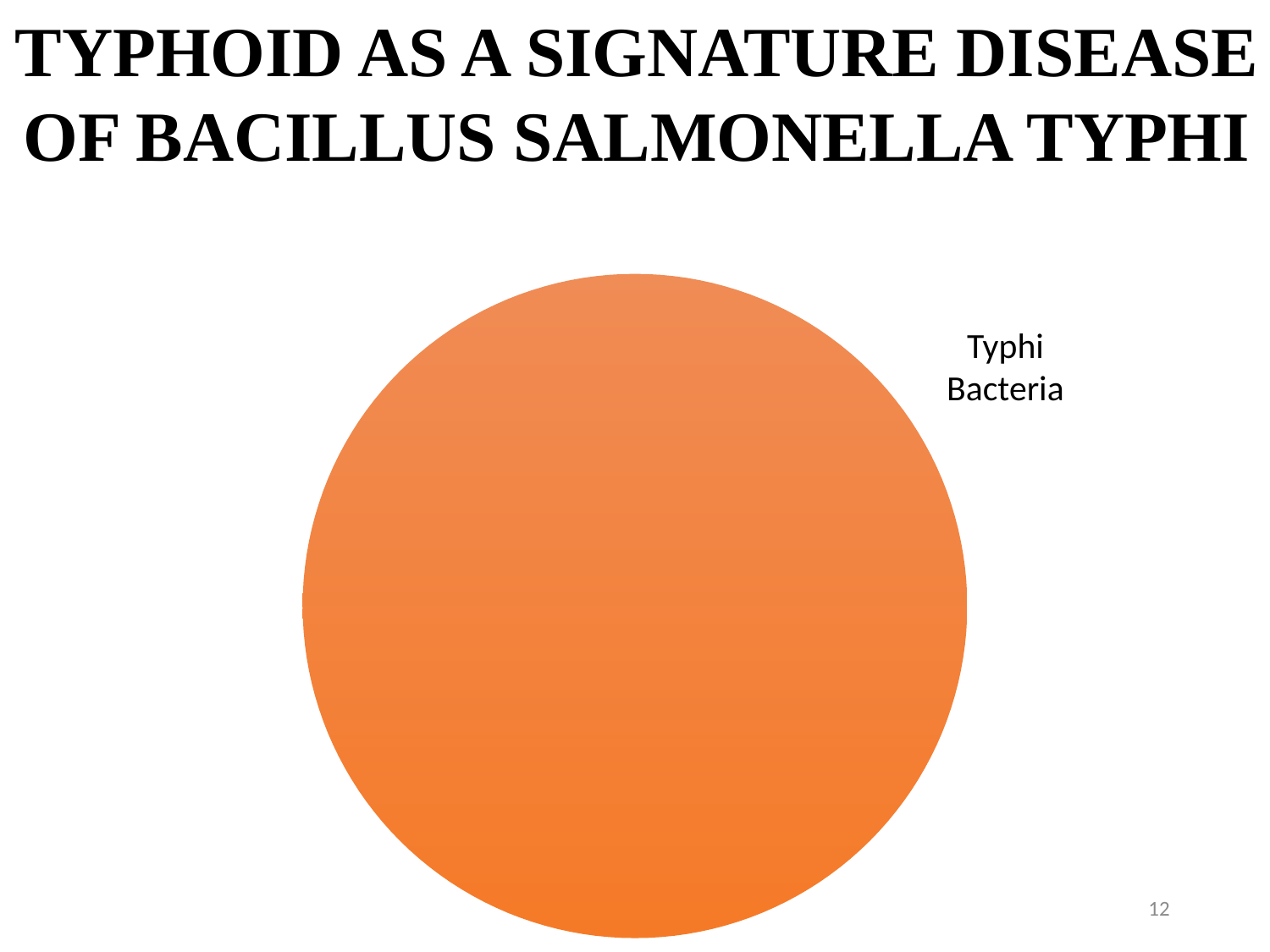
What is the label of the only slice in the pie chart? Typhi Bacteria What share of the pie does the Typhi Bacteria slice take up? 100% How many slices does the pie chart have? 1 What kind of chart is shown on the slide? pie chart What colour is the Typhi Bacteria slice in the pie chart? orange